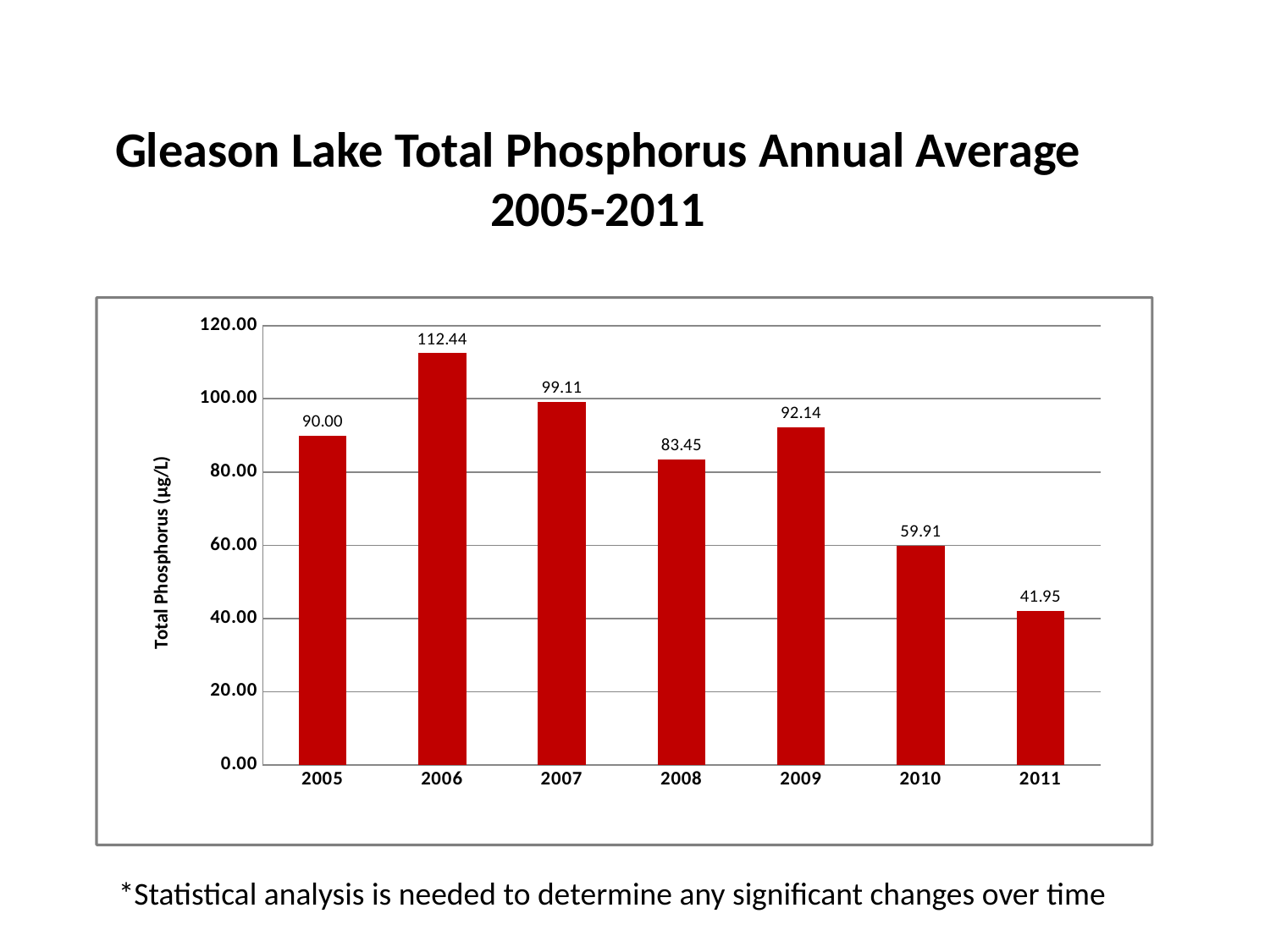
What is the total phosphorus annual average for 2006? 112.44 Which year has the lowest total phosphorus annual average? 2011 What is the total phosphorus annual average for 2008? 83.45 What kind of chart is shown on the slide? bar chart Which year has a larger value, 2007 or 2009? 2007 Which year has the highest total phosphorus annual average? 2006 What is the difference between the 2006 and 2011 values? 70.49 What is the total phosphorus annual average for 2011? 41.95 What is the label of the y axis? Total Phosphorus (µg/L) Is the value for 2010 greater or less than 60.00? less How many years are shown on the x axis? 7 What is the difference between the 2005 and 2010 values? 30.09